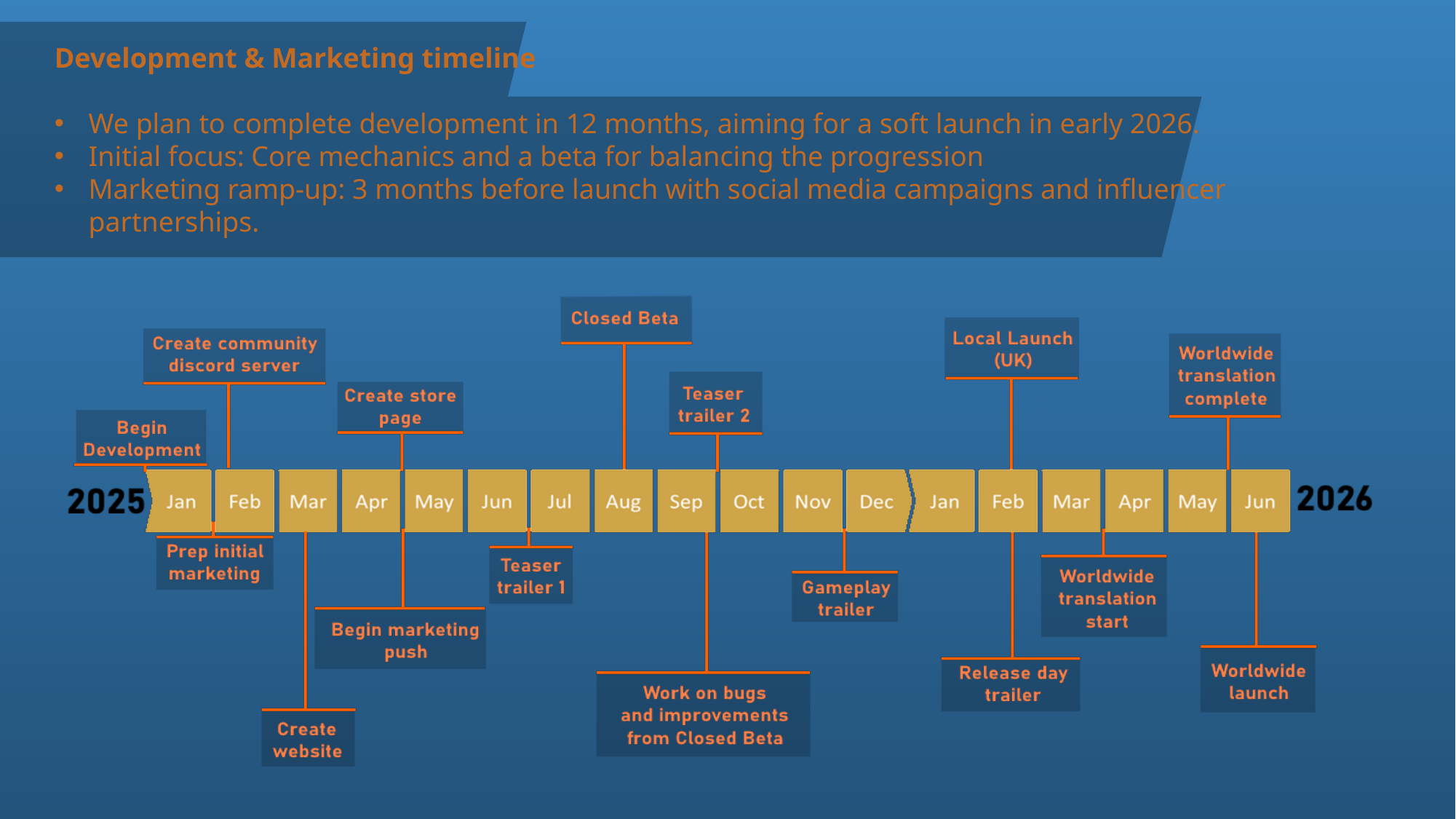
In which month is the Worldwide launch scheduled? Jun 2026 In which month does the timeline begin? Jan 2025 In which month is the Closed Beta scheduled? Aug 2025 In which month is the Create website milestone placed? Mar 2025 Which milestone is placed at the very start of the timeline? Begin Development In which month is the Local Launch (UK) scheduled? Feb 2026 How many months are shown on the timeline? 18 In which month does the timeline end? Jun 2026 What is the title of the slide containing the timeline? Development & Marketing timeline What kind of chart is shown on the slide? Timeline Which two years are labelled at the ends of the timeline? 2025 and 2026 Which comes first on the timeline, the Closed Beta or the Local Launch (UK)? Closed Beta